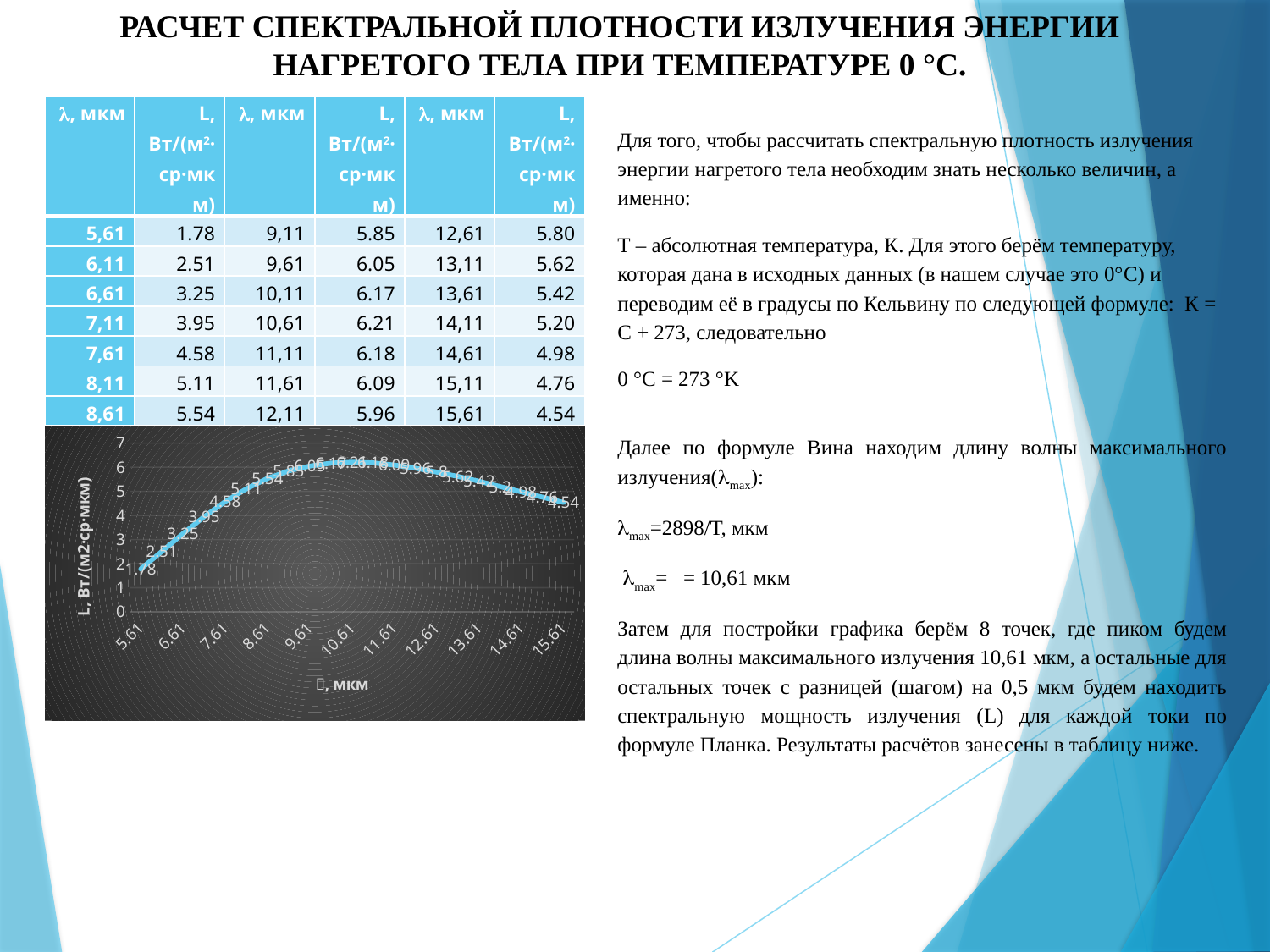
Do the values rise or fall along the x axis from 12,61 to 15,61 мкм? fall What is the value of L at λ = 5,61 мкм on the chart? 1.78 What is the value of L at λ = 6,61 мкм on the chart? 3.25 Is the value for λ = 5,61 мкм greater or less than 2? less At which λ value is the plotted L lowest? 5,61 What is the value of L at λ = 15,61 мкм on the chart? 4.54 What is the difference between the value at 15,61 мкм and the value at 5,61 мкм? 2.76 What kind of chart is shown on the slide? line chart What is the title of the vertical axis of the chart? L, Вт/(м2·ср·мкм) Do the values rise or fall along the x axis from 5,61 to 9,61 мкм? rise Is the value for λ = 10,61 мкм greater or less than 5? greater Which is larger on the chart: the value at 5,61 мкм or the value at 15,61 мкм? 15,61 мкм